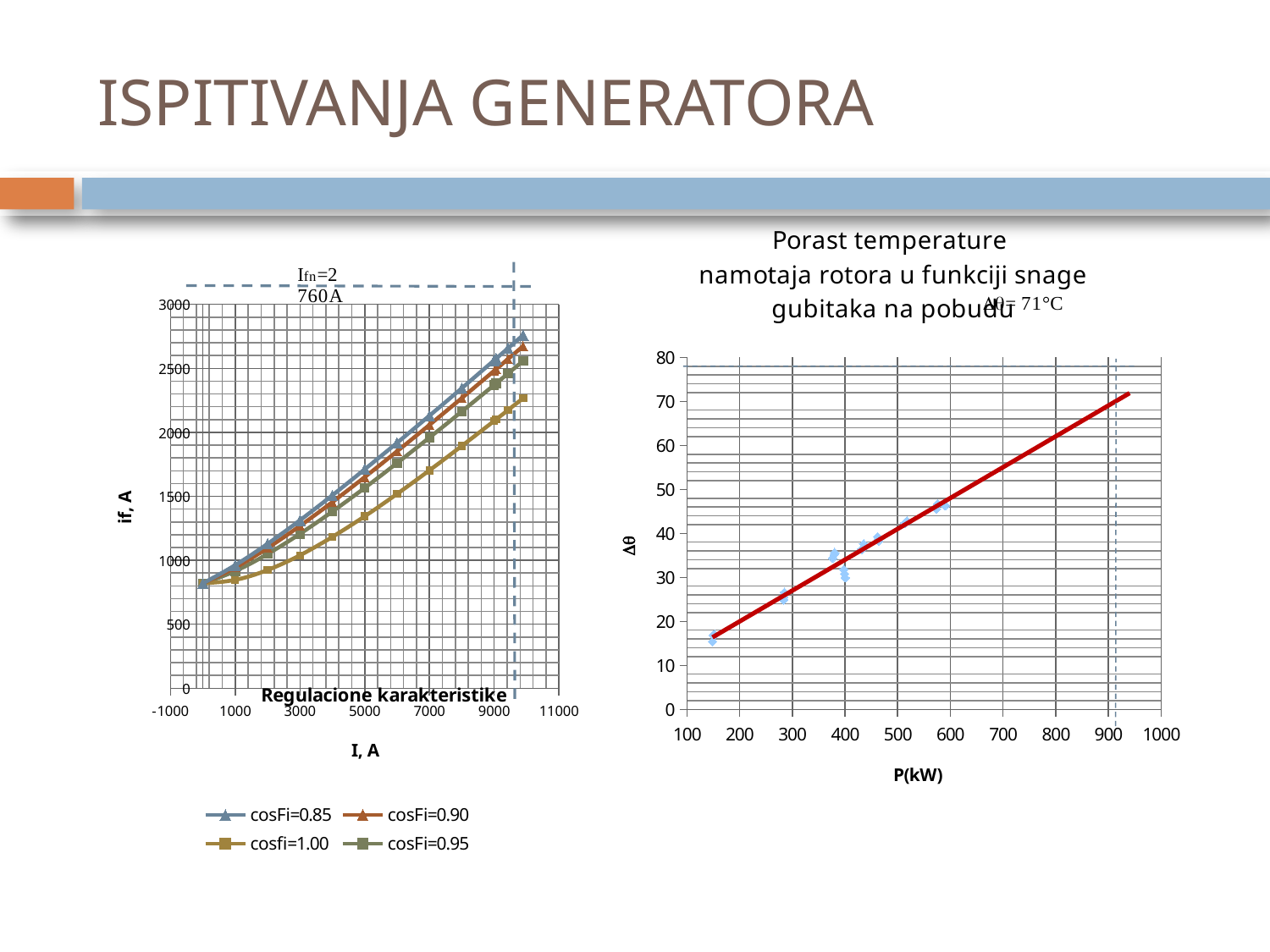
In the 'Regulacione karakteristike' chart, which series has the highest value at I = 9000 A? cosFi=0.85 In the 'Regulacione karakteristike' chart, do the series values rise or fall as I increases? rise How many series does the legend of the 'Regulacione karakteristike' chart list? 4 In the 'Regulacione karakteristike' chart, is the value of cosfi=1.00 at I = 9000 A greater or less than 2500? less In the 'Porast temperature namotaja rotora' chart, is the value of Δθ at P = 300 kW greater or less than 30? less What is the x-axis title of the 'Porast temperature namotaja rotora' chart on the right? P(kW) What is the y-axis title of the 'Regulacione karakteristike' chart? if, A In the 'Porast temperature namotaja rotora' chart, is the value of the trend line at P = 900 kW greater or less than 60? greater What kind of chart is the 'Regulacione karakteristike' chart on the left? line chart In the 'Porast temperature namotaja rotora' chart, does Δθ rise or fall as P increases? rise In the 'Regulacione karakteristike' chart, which series has the lowest value at I = 9000 A? cosfi=1.00